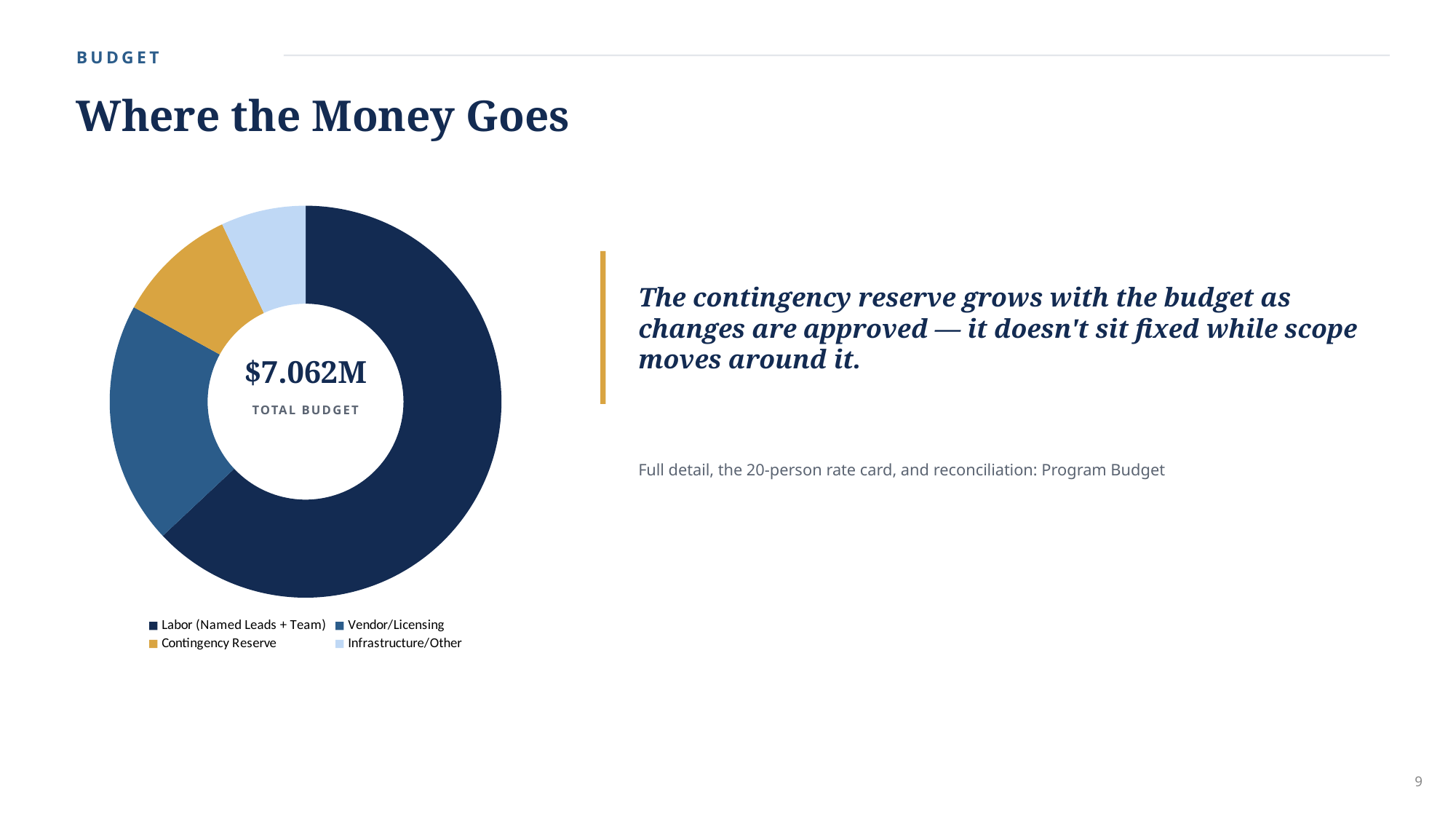
Which is larger in the donut chart, Labor (Named Leads + Team) or Infrastructure/Other? Labor (Named Leads + Team) What is the title of the slide containing the donut chart? Where the Money Goes What colour represents Contingency Reserve in the donut chart? gold What kind of chart is shown on the slide? donut chart Which is larger in the donut chart, Labor (Named Leads + Team) or Vendor/Licensing? Labor (Named Leads + Team) Which category takes the largest share of the budget in the donut chart? Labor (Named Leads + Team) What total budget is printed in the centre of the donut chart? $7.062M How many categories does the donut chart show? 4 Which is larger in the donut chart, Vendor/Licensing or Contingency Reserve? Vendor/Licensing